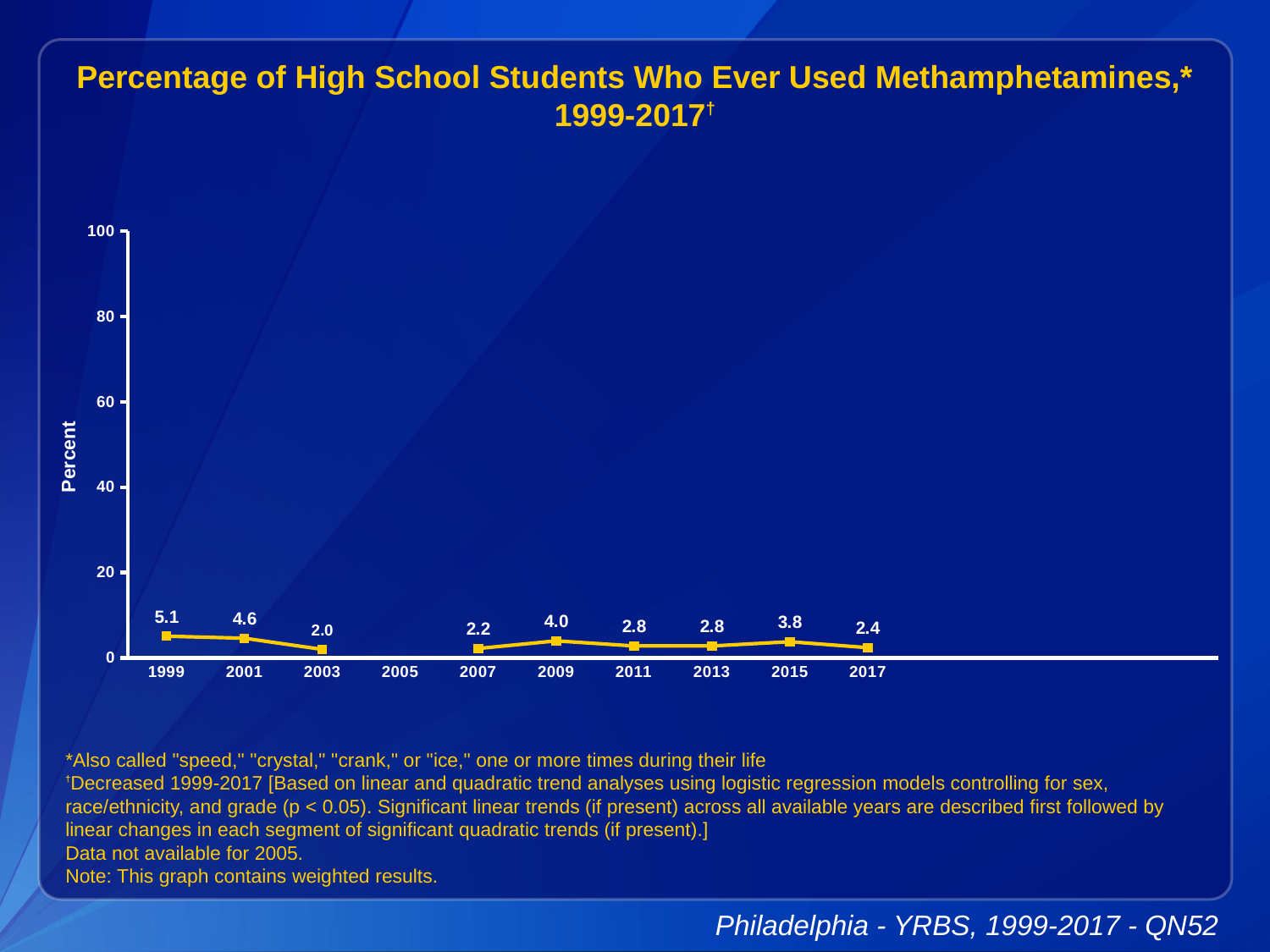
Which year on the x axis has no data point plotted? 2005 Which year has the highest percentage? 1999 Is the value for 2009 greater or less than 20? less What is the difference between the 1999 value and the 2017 value? 2.7 Which year has a larger value, 2015 or 2011? 2015 Overall, do the values rise or fall from 1999 to 2017? fall What percentage of high school students had ever used methamphetamines in 1999? 5.1 What kind of chart is shown on the slide? line chart Which year has the lowest percentage? 2003 How many years have data points plotted on the chart? 9 What is the value plotted for 2009? 4.0 What is the value plotted for 2017? 2.4